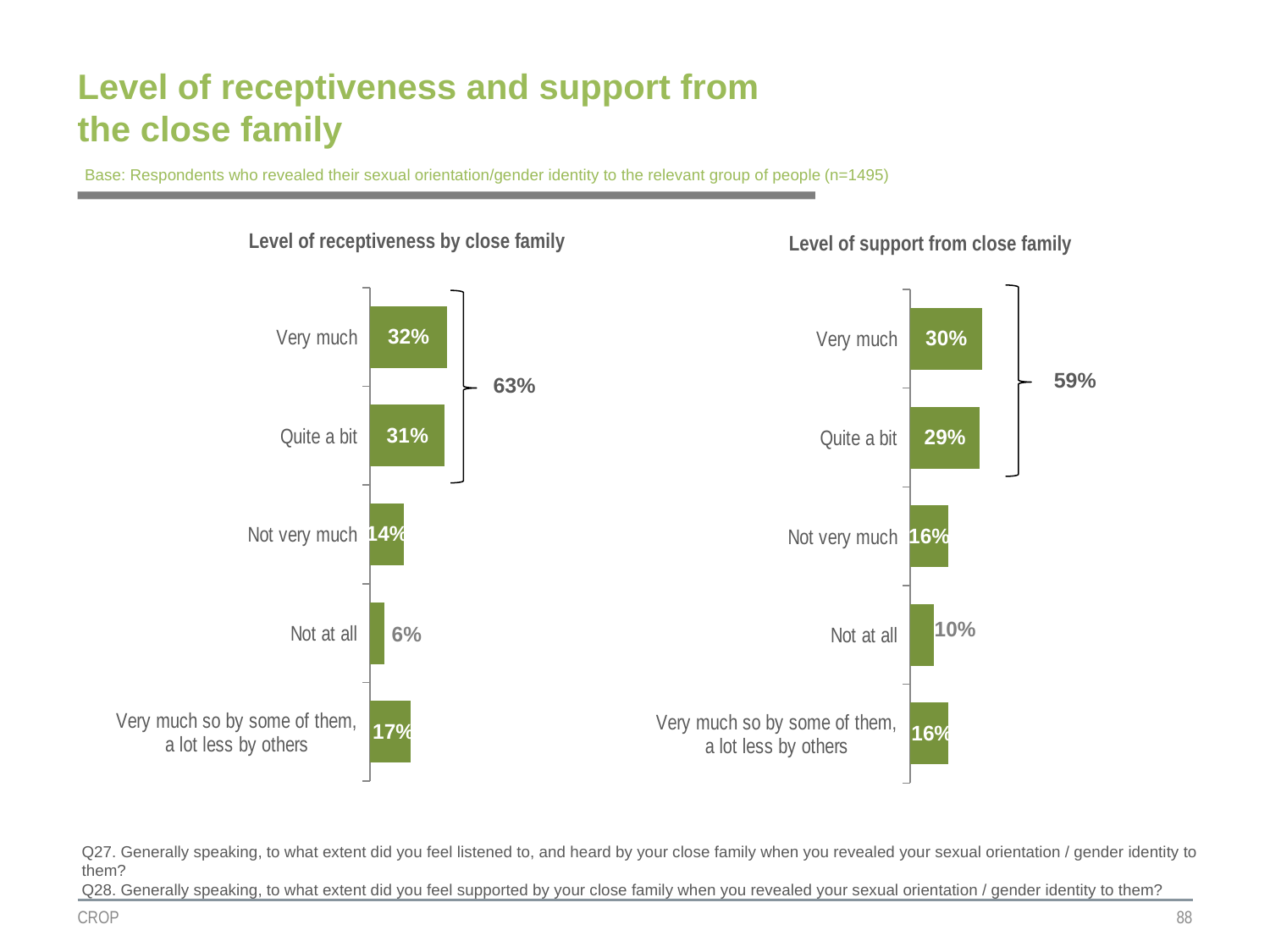
What type of chart is the 'Level of receptiveness by close family' chart? Bar chart In the 'Level of support from close family' chart, what is the value for 'Not at all'? 10% In the 'Level of receptiveness by close family' chart, which is larger: 'Not very much' or 'Not at all'? Not very much In the 'Level of receptiveness by close family' chart, what is the value for 'Very much'? 32% What is the title of the chart on the right side of the slide? Level of support from close family In the 'Level of receptiveness by close family' chart, what combined value is shown by the bracket for 'Very much' and 'Quite a bit'? 63% In the 'Level of support from close family' chart, what is the difference between 'Very much' and 'Not very much'? 14% In the 'Level of receptiveness by close family' chart, what is the value for 'Very much so by some of them, a lot less by others'? 17% In the 'Level of support from close family' chart, what combined value is shown by the bracket for 'Very much' and 'Quite a bit'? 59% In the 'Level of receptiveness by close family' chart, which category has the lowest value? Not at all How many categories are shown in the 'Level of support from close family' chart? 5 In the 'Level of support from close family' chart, which category has the highest value? Very much